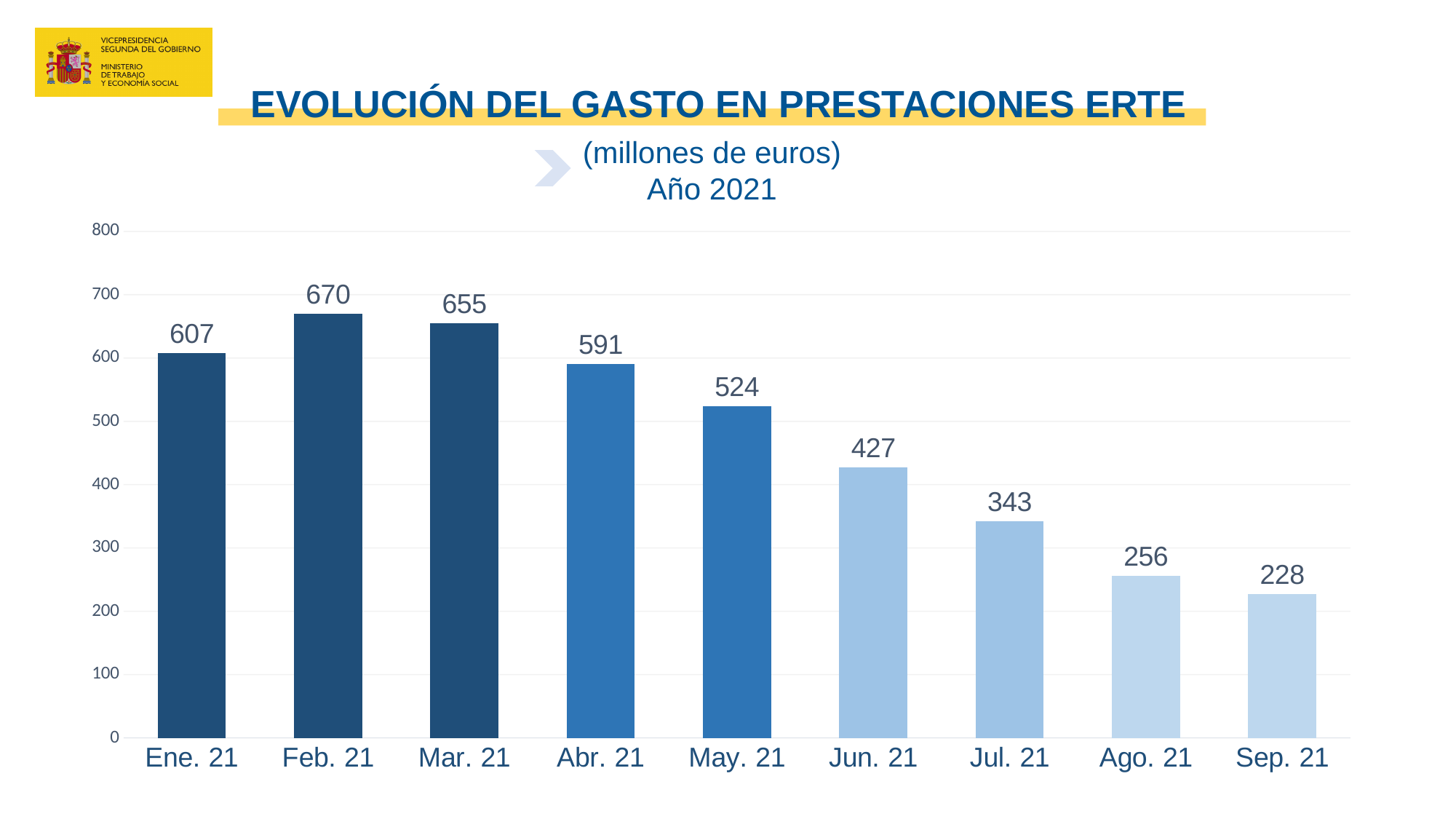
What is the value for Feb. 21? 670 Which is larger, the value for Ene. 21 or the value for Mar. 21? Mar. 21 Which month has the lowest value? Sep. 21 What is the value for Sep. 21? 228 Do the values rise or fall from Feb. 21 to Sep. 21? fall What is the difference between the values for Jun. 21 and Jul. 21? 84 What kind of chart is shown on the slide? bar chart Which month has the highest value? Feb. 21 What is the difference between the values for Feb. 21 and Sep. 21? 442 What is the value for May. 21? 524 Is the value for Ago. 21 greater or less than 300? less How many months are shown on the chart? 9